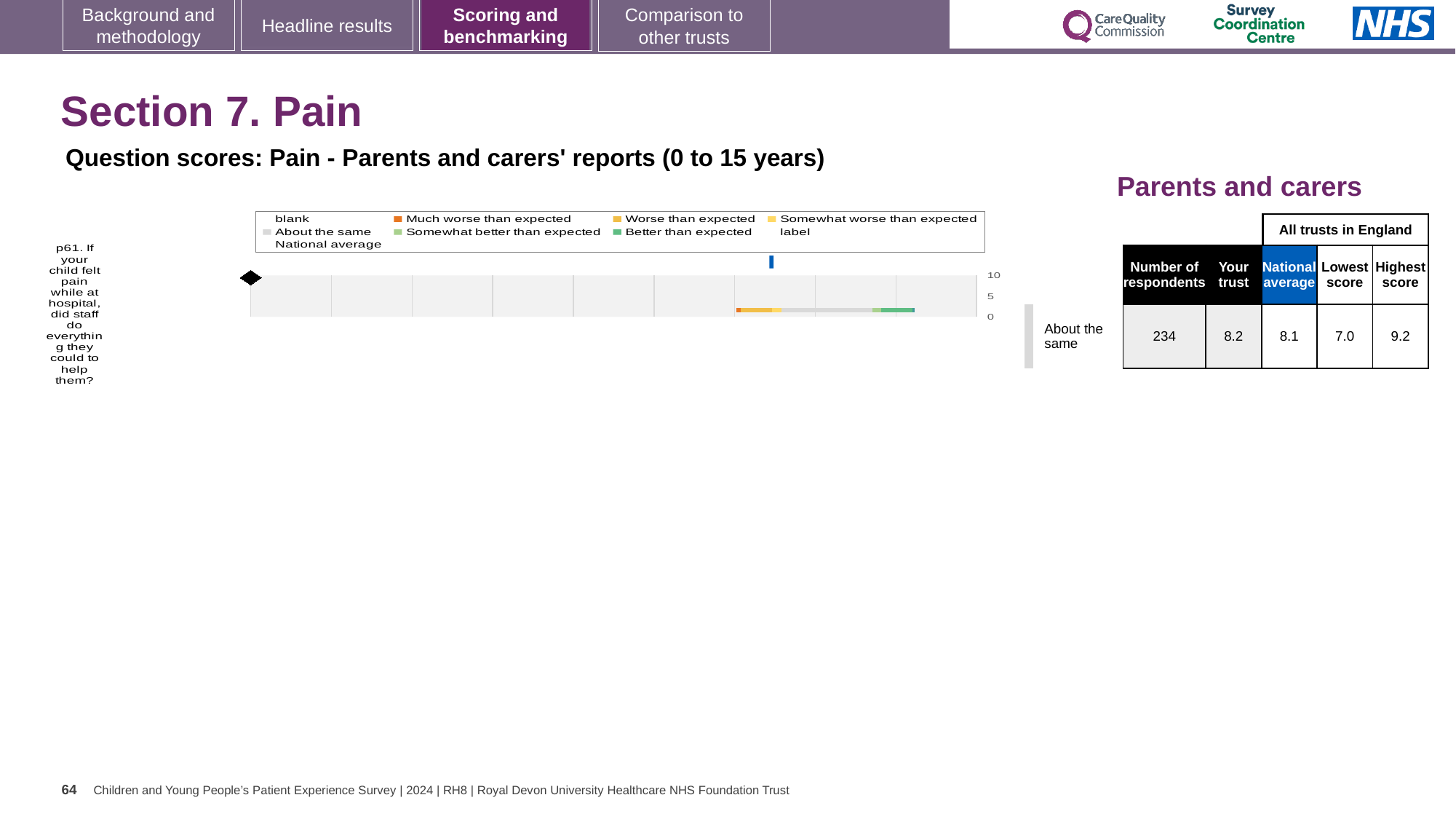
What is the national average score for question p61? 8.1 Which colour in the legend represents 'Better than expected'? green How is the trust's result for question p61 categorised relative to what was expected? About the same What kind of chart is shown on the slide for question p61? bar chart What is the lowest score among all trusts in England for question p61? 7.0 How many respondents answered question p61? 234 Which is higher for question p61: the 'Your trust' score or the national average? Your trust What is the highest score among all trusts in England for question p61? 9.2 What is the 'Your trust' score for question p61 (If your child felt pain while at hospital, did staff do everything they could to help them?)? 8.2 How many survey questions are plotted in the chart on the slide? 1 What is the difference between the highest score and the lowest score for question p61? 2.2